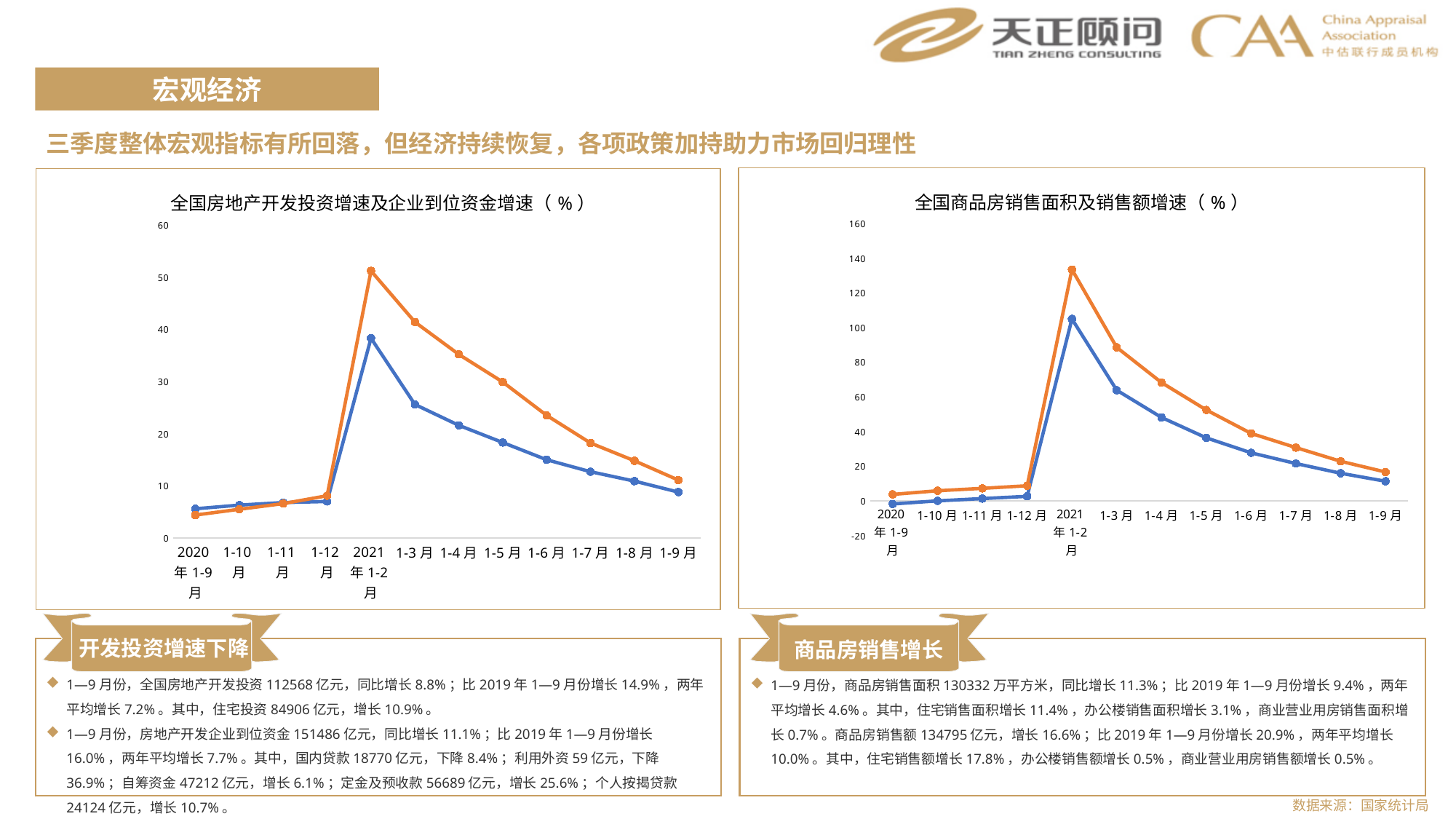
What type of chart is the left chart titled 全国房地产开发投资增速及企业到位资金增速（%）? line chart In the right chart (全国商品房销售面积及销售额增速), is the orange line's value at 1-9月 (2021) greater or less than 20? less In the right chart (全国商品房销售面积及销售额增速), at which period does the blue line reach its highest value? 2021年1-2月 In the left chart (全国房地产开发投资增速及企业到位资金增速), at which period does the orange line reach its highest value? 2021年1-2月 How many time periods are shown on the x axis of the left chart (全国房地产开发投资增速及企业到位资金增速)? 12 In the left chart (全国房地产开发投资增速及企业到位资金增速), which line is higher at 2021年1-2月, the orange line or the blue line? the orange line In the right chart (全国商品房销售面积及销售额增速), do the values rise or fall from 2021年1-2月 to 1-9月? fall In the right chart (全国商品房销售面积及销售额增速), at which period is the blue line at its lowest value? 2020年1-9月 In the left chart (全国房地产开发投资增速及企业到位资金增速), is the orange line's value at 2021年1-2月 greater or less than 40? greater In the right chart (全国商品房销售面积及销售额增速), is the orange line's value at 2021年1-2月 greater or less than 120? greater How many lines are plotted in the right chart (全国商品房销售面积及销售额增速)? 2 What type of chart is the right chart titled 全国商品房销售面积及销售额增速（%）? line chart